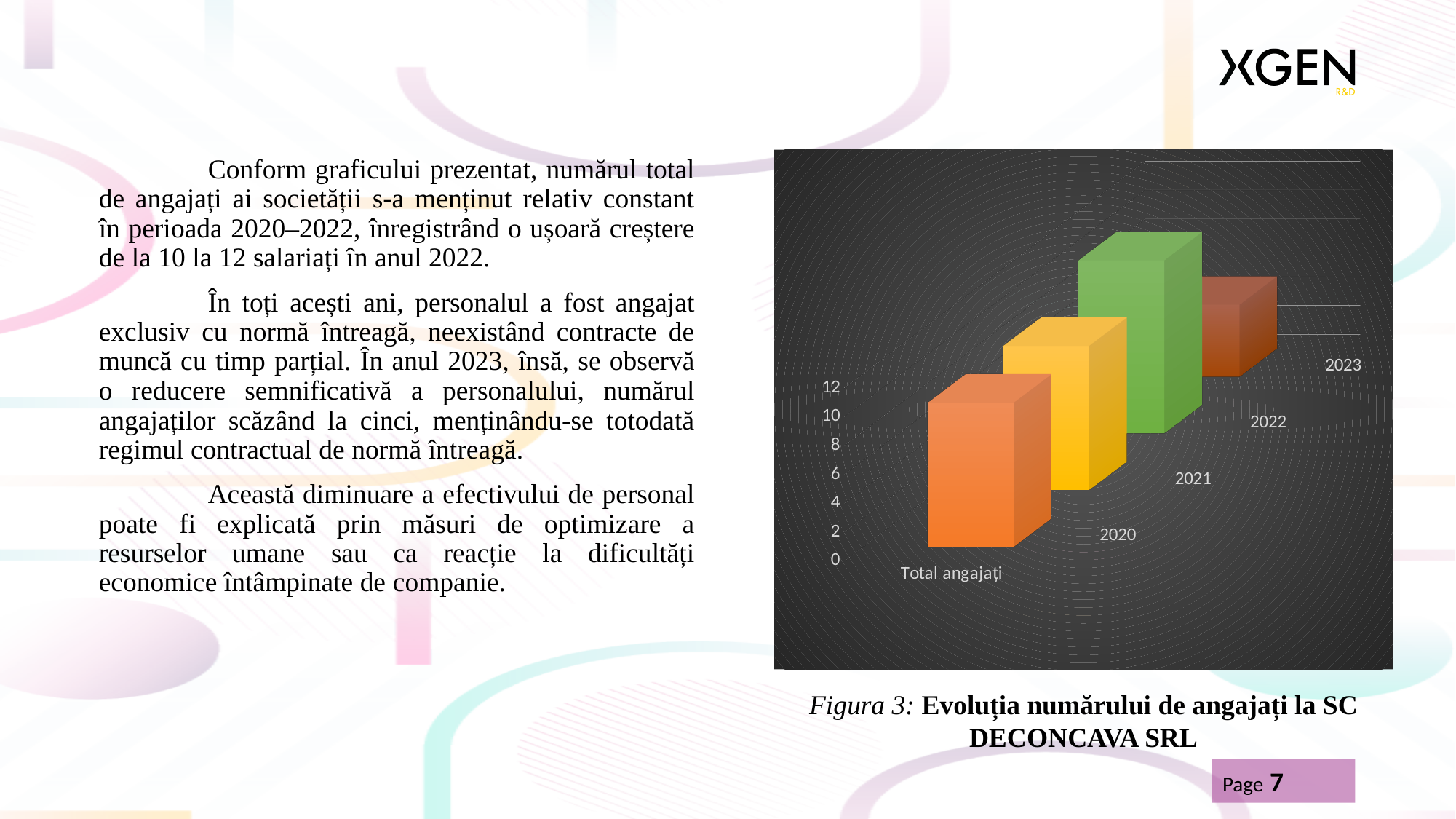
Is the bar for 2020 taller or shorter than the bar for 2023? taller Is the bar for 2022 taller or shorter than the bar for 2023? taller How many years are plotted in the chart? 4 Which year has the highest bar in the chart? 2022 Is the value for 2022 greater or less than 8? greater What is the label shown on the category axis of the chart? Total angajați Is the value for 2023 greater or less than 8? less Which year has the lowest bar in the chart? 2023 What is the highest tick value shown on the vertical axis? 12 What is the figure caption of the chart? Figura 3: Evoluția numărului de angajați la SC DECONCAVA SRL Is the value for 2020 greater or less than 6? greater What kind of chart is shown on the slide? bar chart